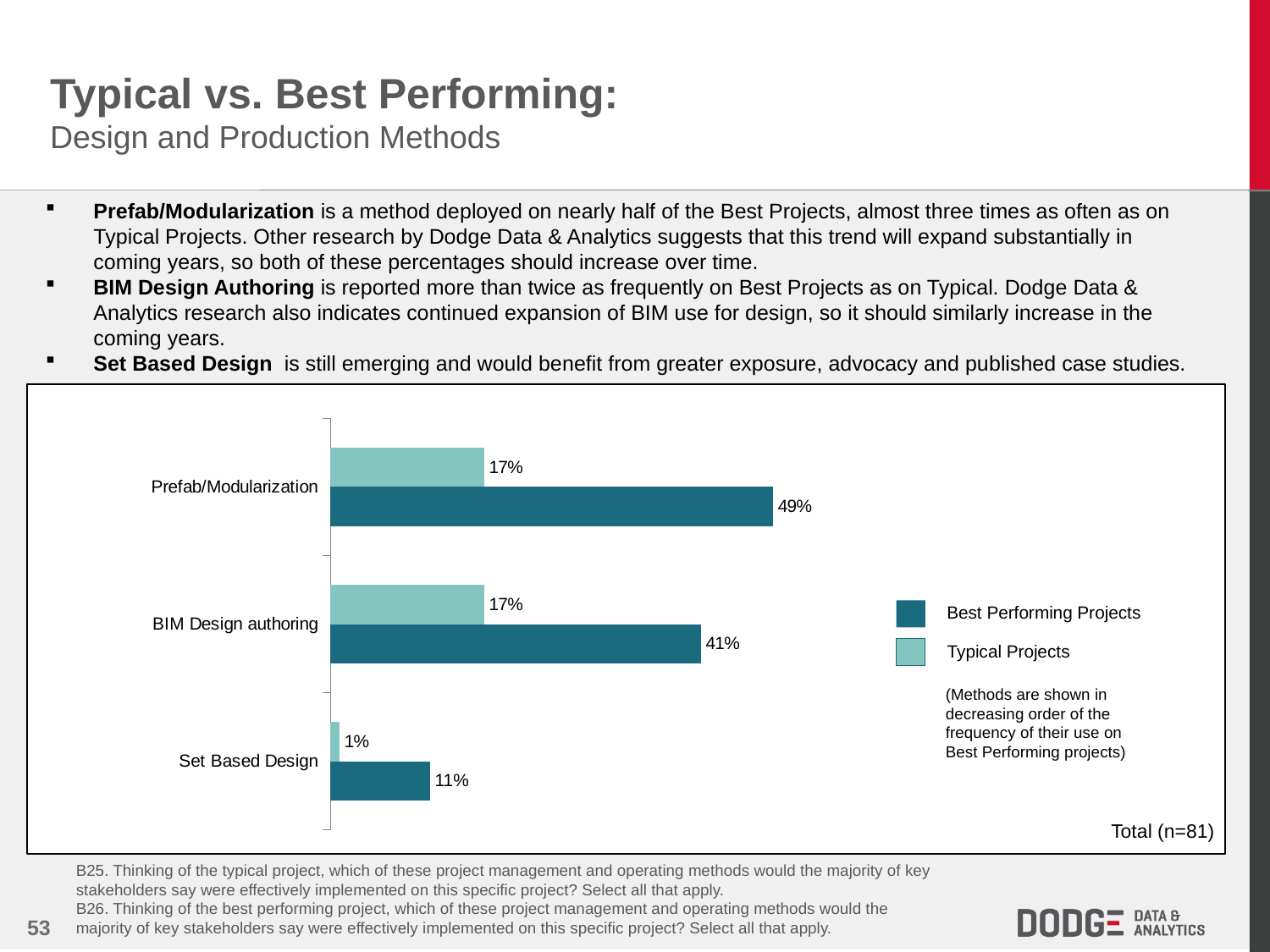
Which method has the lowest value for Typical Projects? Set Based Design Which method has the highest value for Best Performing Projects? Prefab/Modularization What percentage of Typical Projects use BIM Design authoring? 17% What is the difference between Best Performing Projects and Typical Projects for Prefab/Modularization? 32 percentage points How many methods are shown in the chart? 3 How many series does the legend list? 2 What percentage of Typical Projects use Set Based Design? 1% What percentage of Best Performing Projects use Set Based Design? 11% What is the difference between Best Performing Projects and Typical Projects for BIM Design authoring? 24 percentage points What type of chart is shown on the slide? Bar chart What percentage of Best Performing Projects use Prefab/Modularization? 49% For Set Based Design, which is larger: Best Performing Projects or Typical Projects? Best Performing Projects